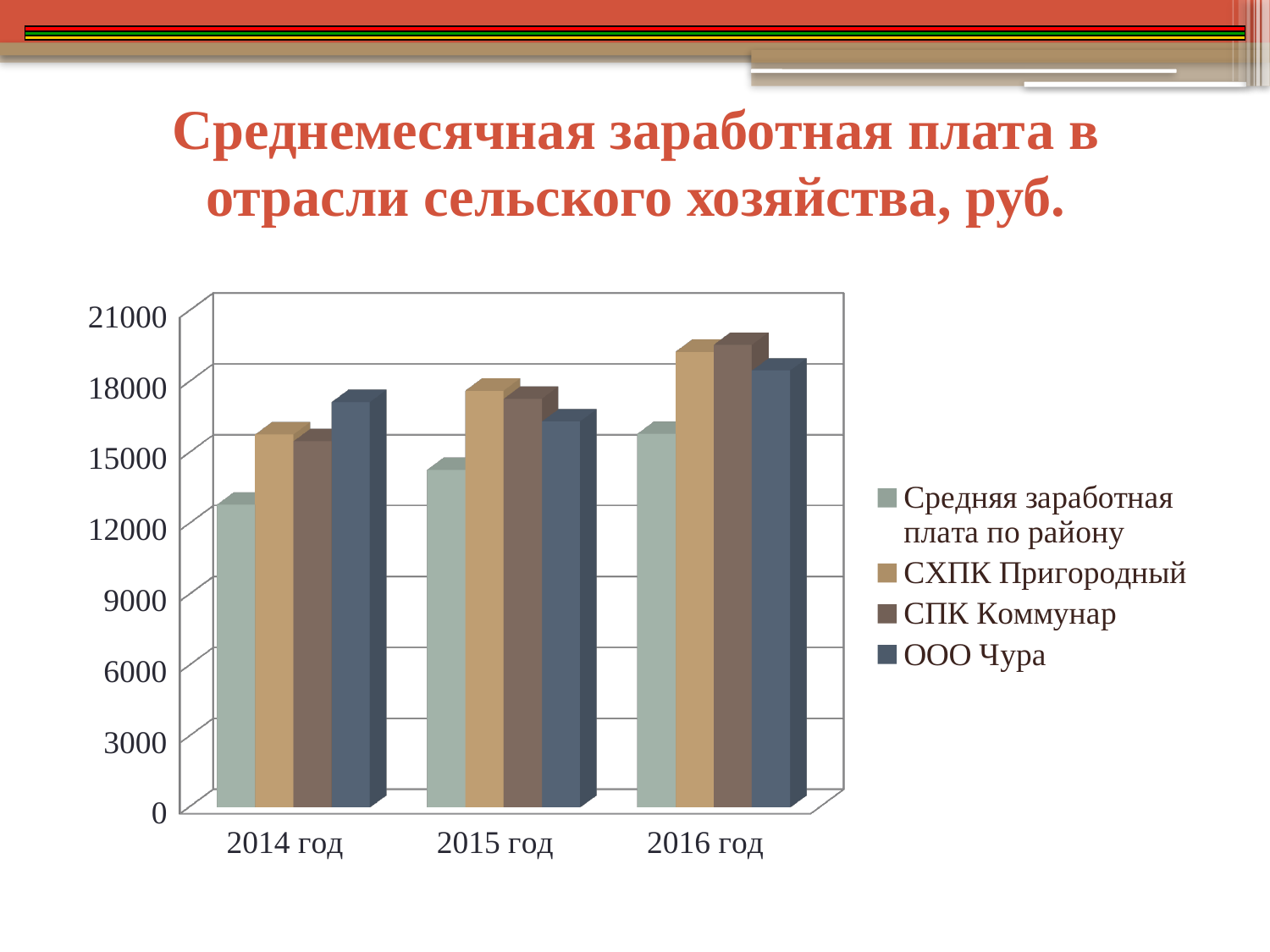
How many series does the legend list? 4 Which series has the highest value in 2014 год? ООО Чура How many year categories are shown on the x axis? 3 Is the value for ООО Чура in 2014 год greater or less than 15000? greater Is the value for Средняя заработная плата по району in 2014 год greater or less than 15000? less Is the value for СПК Коммунар in 2015 год greater or less than 18000? less What is the title of the chart? Среднемесячная заработная плата в отрасли сельского хозяйства, руб. Which is larger in 2015 год: СХПК Пригородный or ООО Чура? СХПК Пригородный What kind of chart is shown on the slide? bar chart Do the values for Средняя заработная плата по району rise or fall from 2014 год to 2016 год? rise Which series has the lowest value in 2016 год? Средняя заработная плата по району